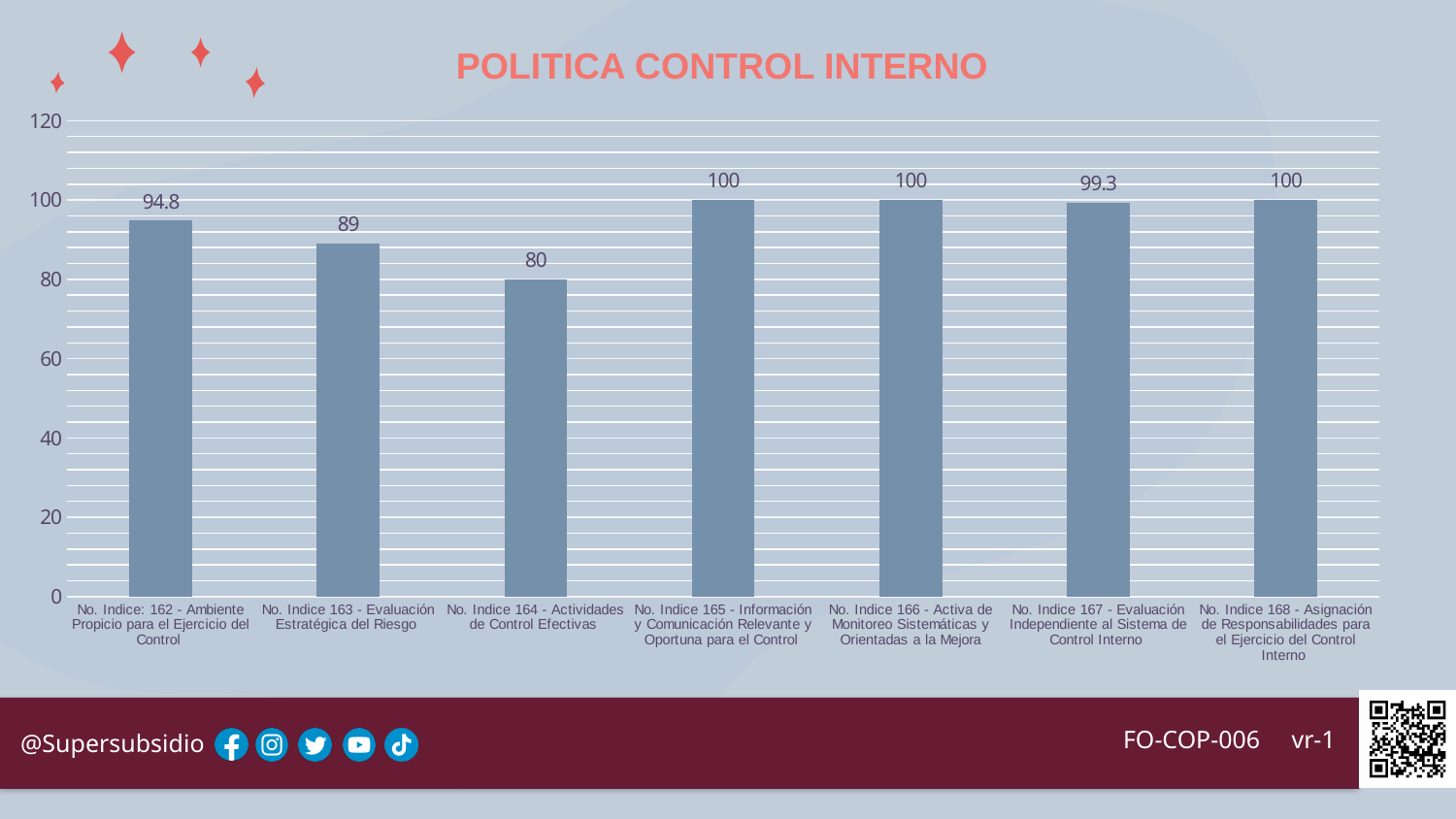
Which is larger, the value for No. Indice 163 - Evaluación Estratégica del Riesgo or the value for No. Indice 167 - Evaluación Independiente al Sistema de Control Interno? No. Indice 167 - Evaluación Independiente al Sistema de Control Interno What is the value for No. Indice 163 - Evaluación Estratégica del Riesgo? 89 What kind of chart is shown on the slide? bar chart What is the difference between the values for No. Indice 165 - Información y Comunicación Relevante y Oportuna para el Control and No. Indice 164 - Actividades de Control Efectivas? 20 Is the value for No. Indice 164 - Actividades de Control Efectivas greater or less than 100? less What is the value for No. Indice 164 - Actividades de Control Efectivas? 80 What is the difference between the values for No. Indice: 162 - Ambiente Propicio para el Ejercicio del Control and No. Indice 163 - Evaluación Estratégica del Riesgo? 5.8 What is the value for No. Indice 167 - Evaluación Independiente al Sistema de Control Interno? 99.3 What is the value for No. Indice: 162 - Ambiente Propicio para el Ejercicio del Control? 94.8 How many categories are shown in the chart? 7 What is the title of the chart? POLITICA CONTROL INTERNO Which category has the lowest value? No. Indice 164 - Actividades de Control Efectivas